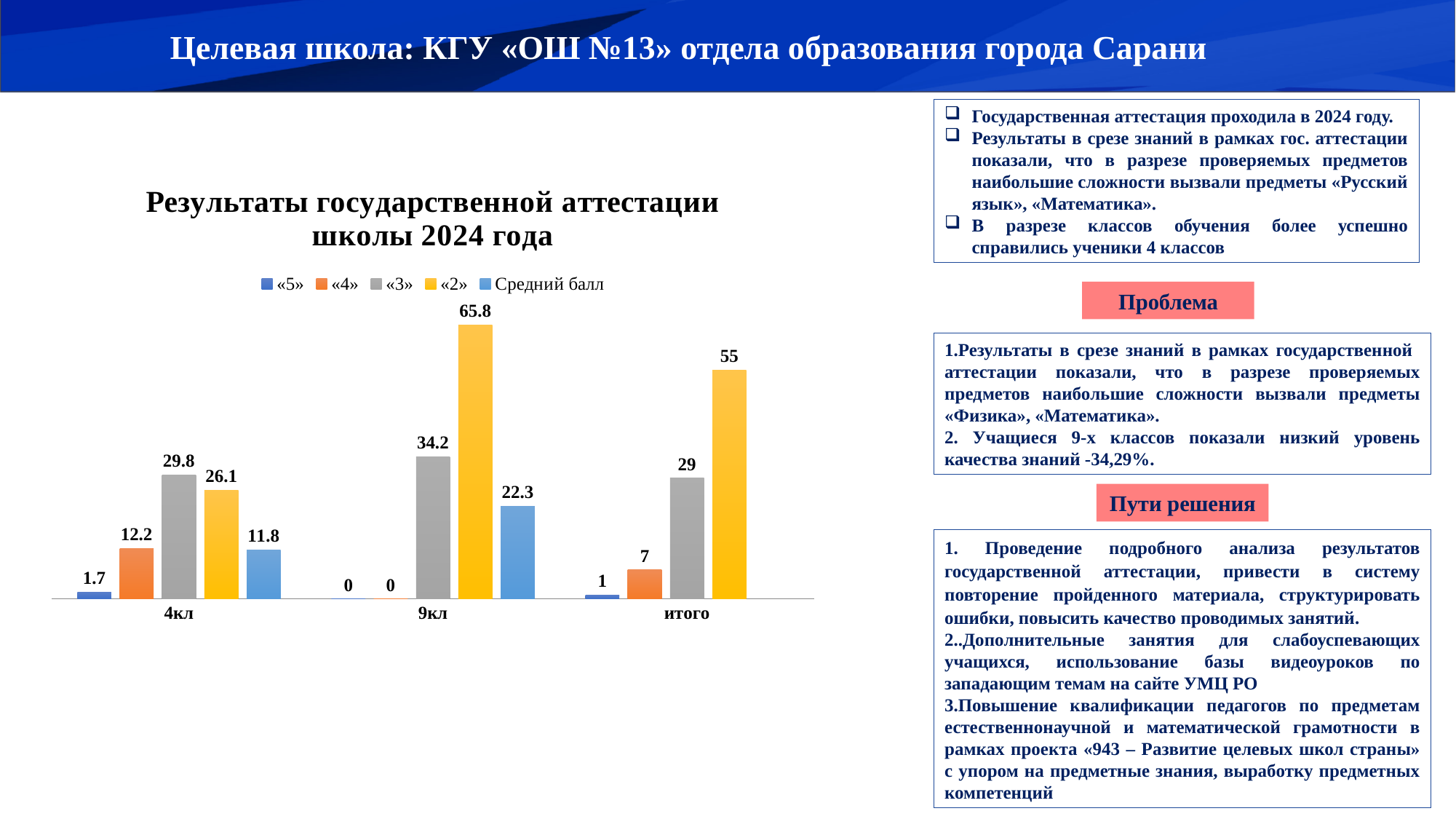
What is the value for «2» in the 9кл category? 65.8 Which is larger in the 4кл category: the value for «3» or the value for «2»? «3» What is the title of the chart? Результаты государственной аттестации школы 2024 года How many series does the legend list? 5 What kind of chart is shown on the slide? Bar chart Which category has the highest value for «2»? 9кл What is the value for «4» in the итого category? 7 What is the value for Средний балл in the 9кл category? 22.3 What is the value for «3» in the 4кл category? 29.8 Which category has the lowest value for «5»? 9кл How many categories are shown on the x axis? 3 What is the difference between the «2» values for 9кл and 4кл? 39.7